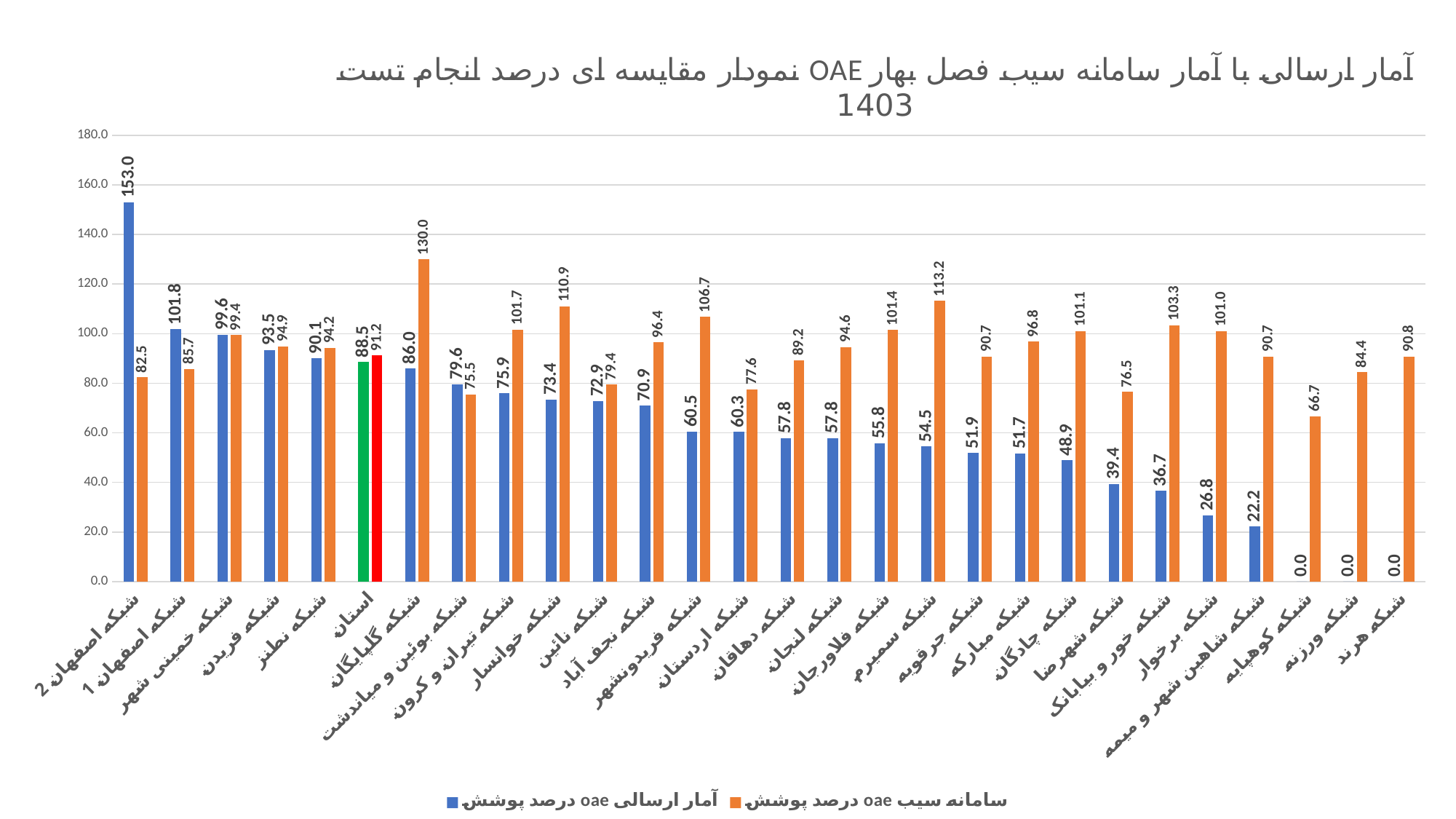
What are the two values shown for استان? 88.5 and 91.2 What kind of chart is shown on the slide? bar chart Which category has the highest value in the blue series (سامانه سیب درصد پوشش oae)? شبکه اصفهان 2 What is the value of the blue series (سامانه سیب درصد پوشش oae) for شبکه اصفهان 2? 153.0 What is the value of the orange series (آمار ارسالی oae درصد پوشش) for شبکه گلپایگان? 130.0 For شبکه بوئین و میاندشت, which series has the larger value, the blue (سامانه سیب) or the orange (آمار ارسالی)? blue (سامانه سیب) What is the value of the orange series (آمار ارسالی oae درصد پوشش) for شبکه سمیرم? 113.2 Which category has the lowest value in the orange series (آمار ارسالی oae درصد پوشش)? شبکه کوهپایه Which category has the highest value in the orange series (آمار ارسالی oae درصد پوشش)? شبکه گلپایگان How many series does the legend list? 2 How many categories are shown on the x axis? 28 What is the difference between the blue and orange values for شبکه خوانسار? 37.5